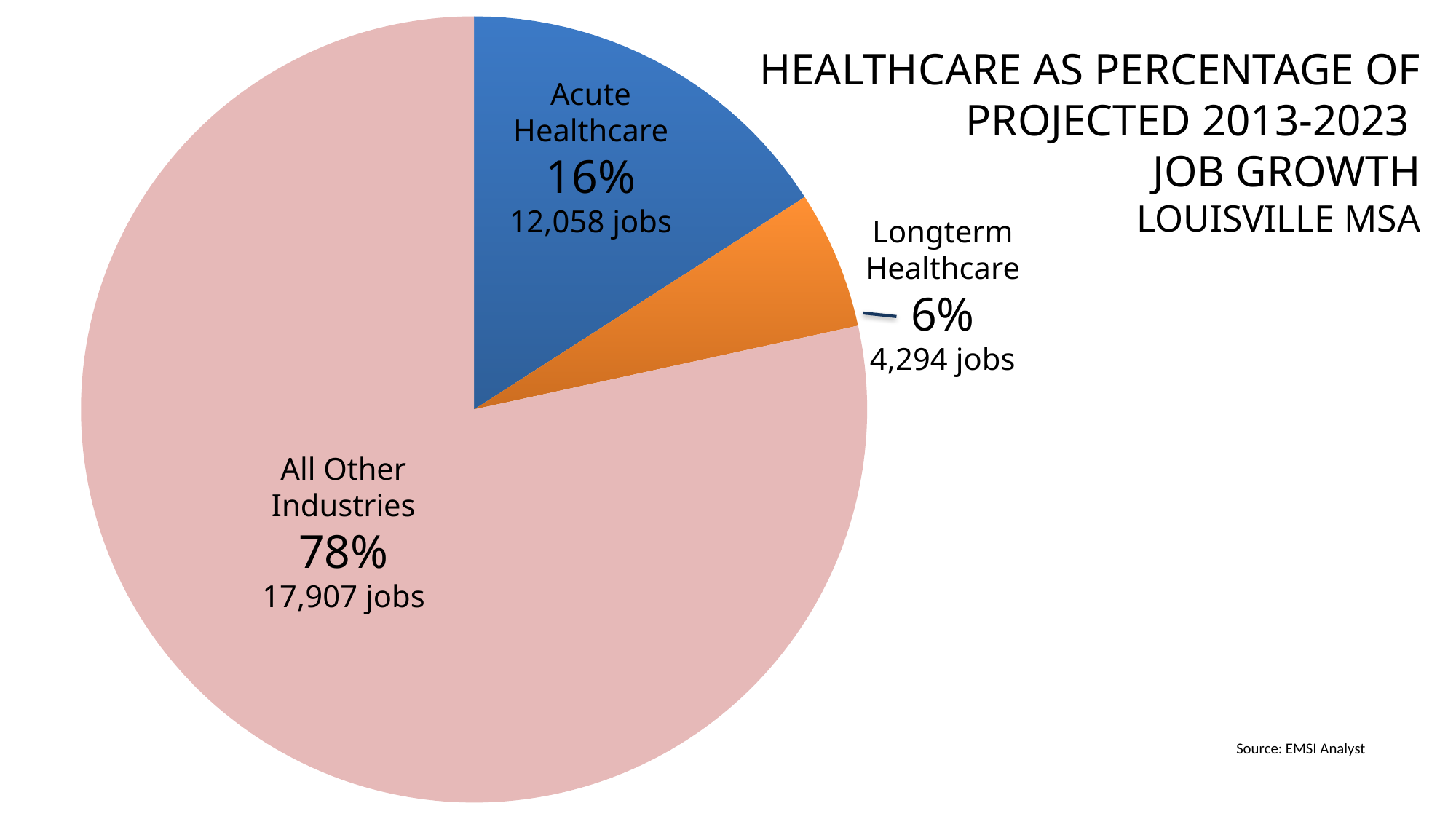
What percentage of projected job growth is attributed to Acute Healthcare? 16% Which slice of the pie is the smallest? Longterm Healthcare What kind of chart is shown on the slide? Pie chart How many slices does the pie chart have? 3 Which slice of the pie is the largest? All Other Industries How many jobs are shown for All Other Industries? 17,907 jobs What source is cited for the chart data? EMSI Analyst What percentage share does Longterm Healthcare have? 6% What is the combined percentage of Acute Healthcare and Longterm Healthcare? 22% Which has more projected jobs, Acute Healthcare or Longterm Healthcare? Acute Healthcare What is the difference in jobs between Acute Healthcare and Longterm Healthcare? 7,764 jobs How many jobs are shown for Longterm Healthcare? 4,294 jobs